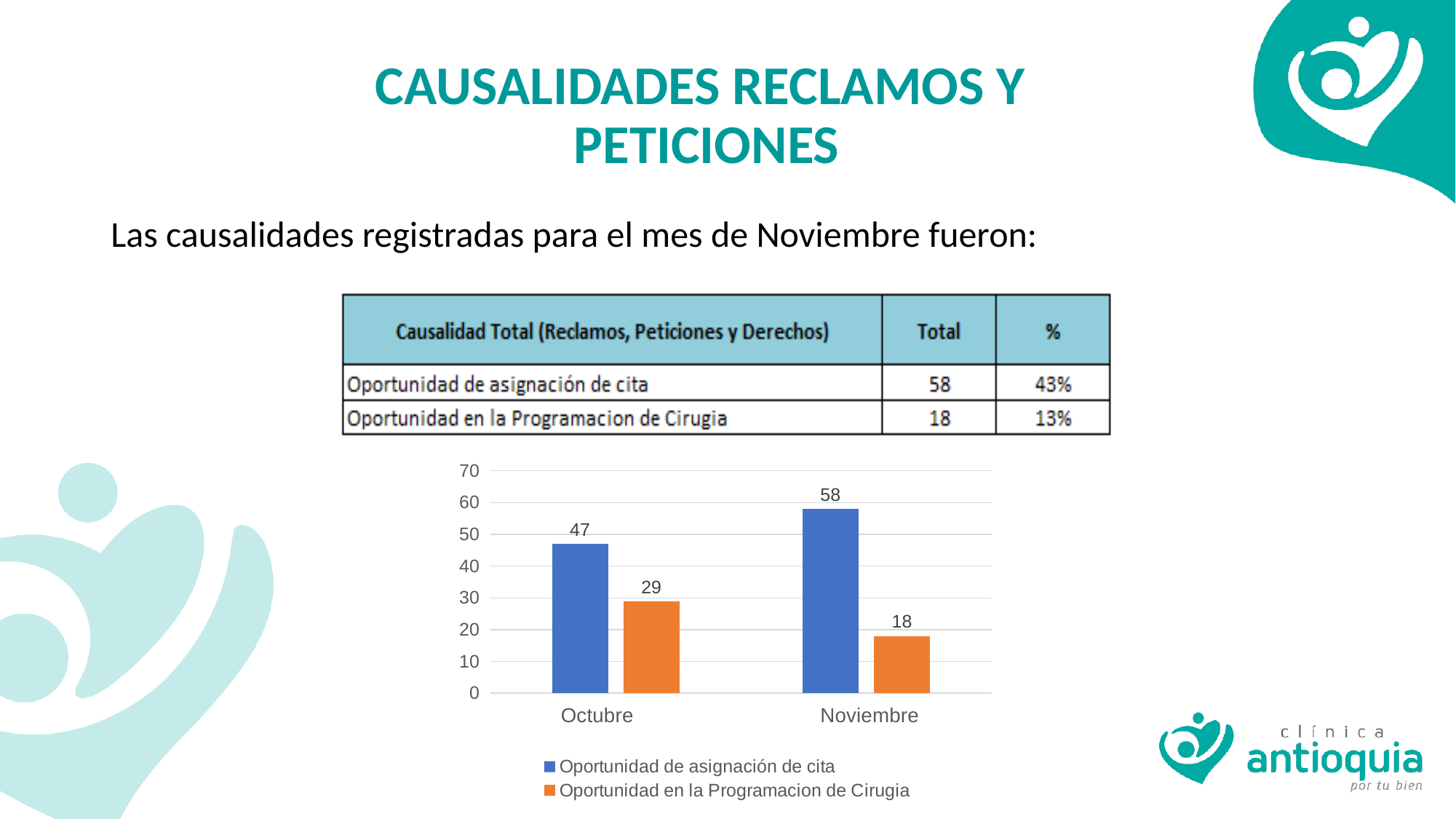
How many months are shown on the x axis of the chart? 2 How many series does the chart legend list? 2 Does the value for Oportunidad en la Programacion de Cirugia rise or fall from Octubre to Noviembre? Fall What is the value for Oportunidad en la Programacion de Cirugia in Octubre? 29 What kind of chart is shown on the slide? Bar chart What is the value for Oportunidad de asignación de cita in Octubre? 47 What is the value for Oportunidad de asignación de cita in Noviembre? 58 What is the value for Oportunidad en la Programacion de Cirugia in Noviembre? 18 Which month has the highest value for Oportunidad de asignación de cita? Noviembre Which is larger in Octubre: Oportunidad de asignación de cita or Oportunidad en la Programacion de Cirugia? Oportunidad de asignación de cita What is the difference between the Oportunidad de asignación de cita values for Noviembre and Octubre? 11 Which month has the lowest value for Oportunidad en la Programacion de Cirugia? Noviembre